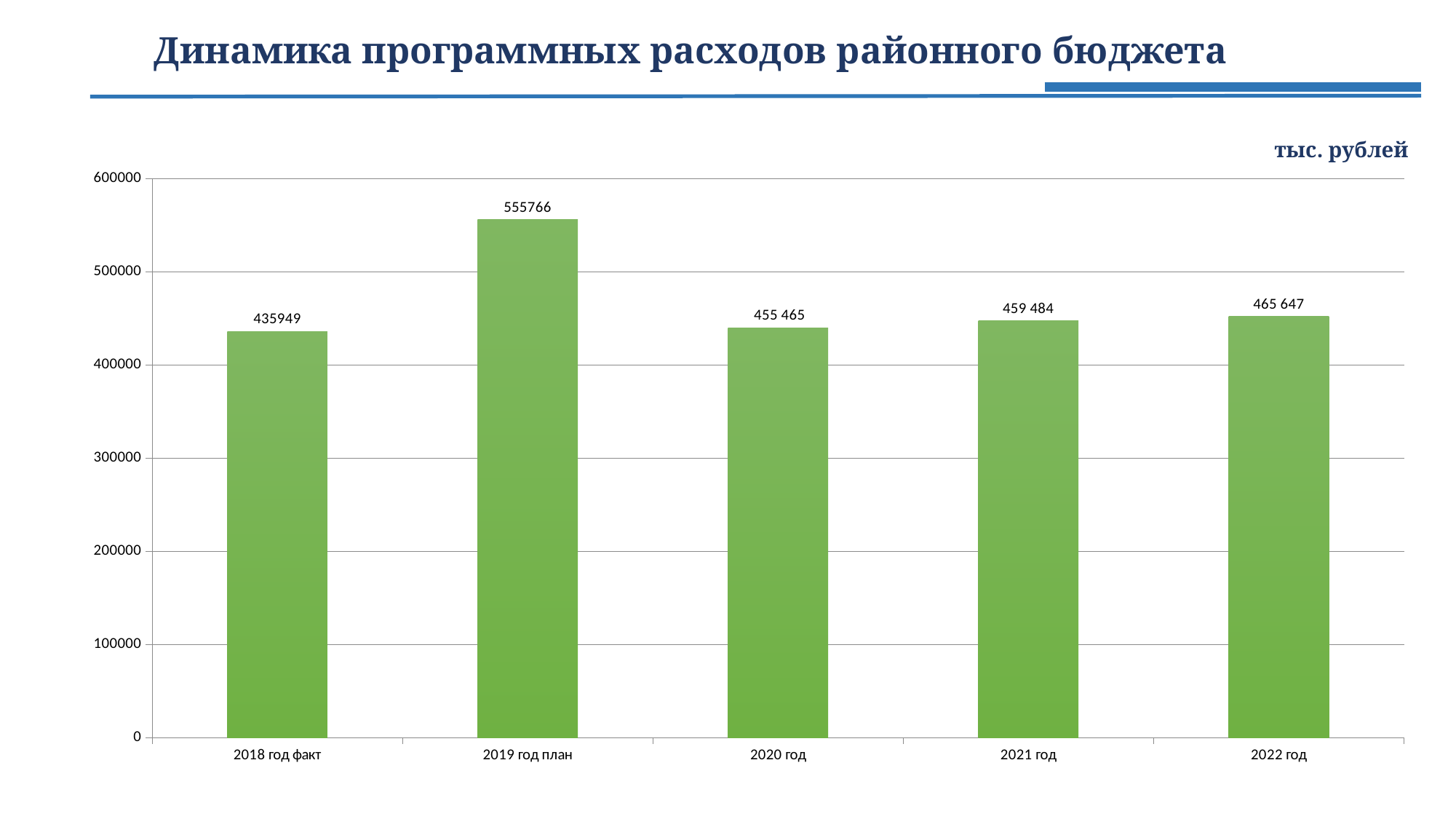
Which category has the highest value? 2019 год план How many bars are shown in the chart? 5 What is the value for 2019 год план? 555766 What is the difference between the values for 2019 год план and 2018 год факт? 119817 What is the value for 2021 год? 459 484 Which is larger, the value for 2020 год or the value for 2022 год? 2022 год Is the value for 2019 год план greater or less than 500000? greater What is the value for 2022 год? 465 647 What unit is indicated for the values in the chart? тыс. рублей What is the value for 2018 год факт? 435949 Which category has the lowest value? 2018 год факт What kind of chart is shown on the slide? bar chart